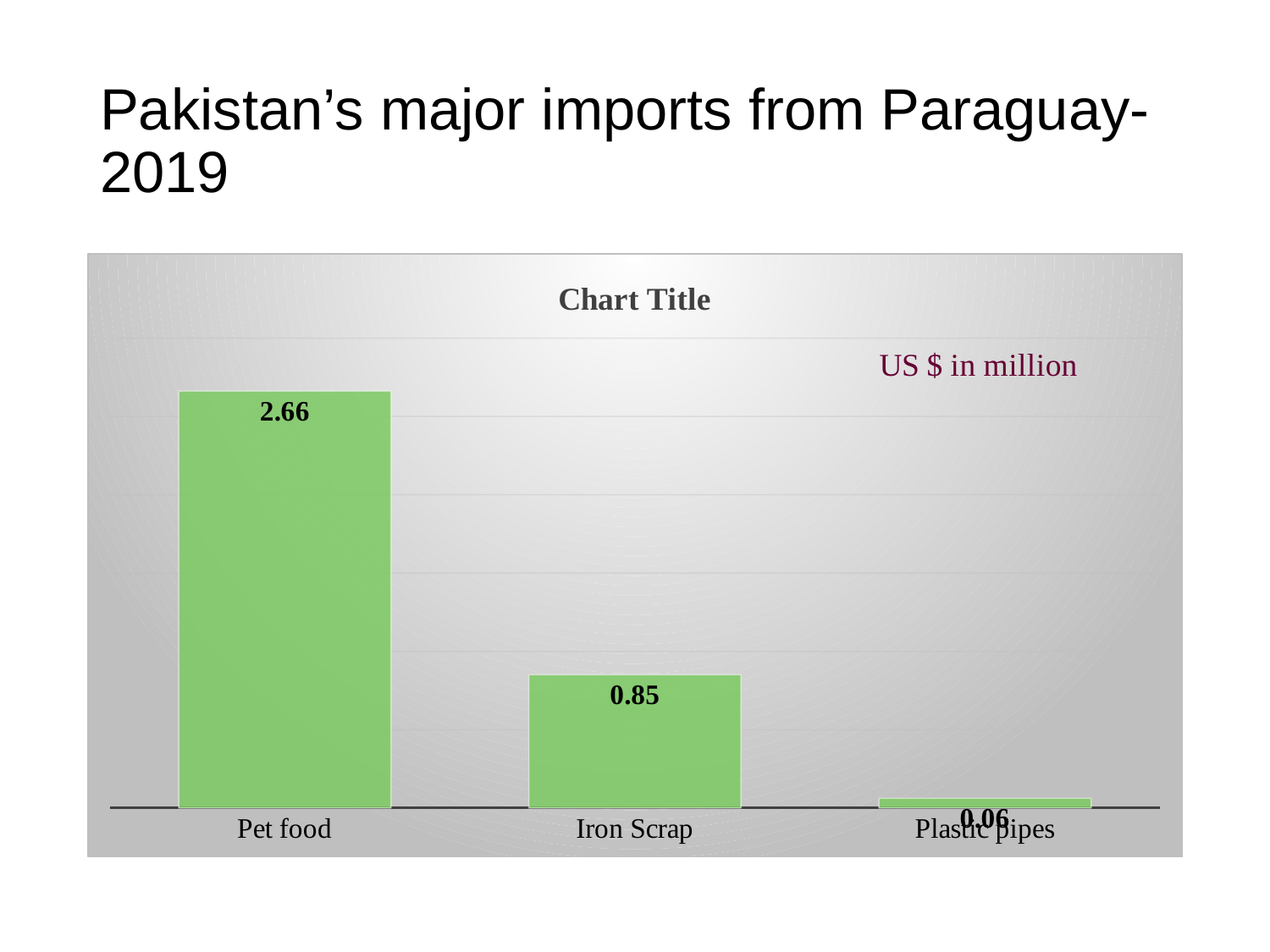
What is the value for Plastic pipes? 0.06 What is the difference between the values for Iron Scrap and Plastic pipes? 0.79 What is the value for Iron Scrap? 0.85 Which category has the highest value? Pet food Which is larger, the value for Iron Scrap or the value for Plastic pipes? Iron Scrap What unit is stated on the chart for the values? US $ in million What is the value for Pet food? 2.66 How many categories are shown in the chart? 3 Which category has the lowest value? Plastic pipes What kind of chart is shown on the slide? Bar chart What is the difference between the values for Pet food and Iron Scrap? 1.81 Do the values rise or fall from left to right across the categories? Fall